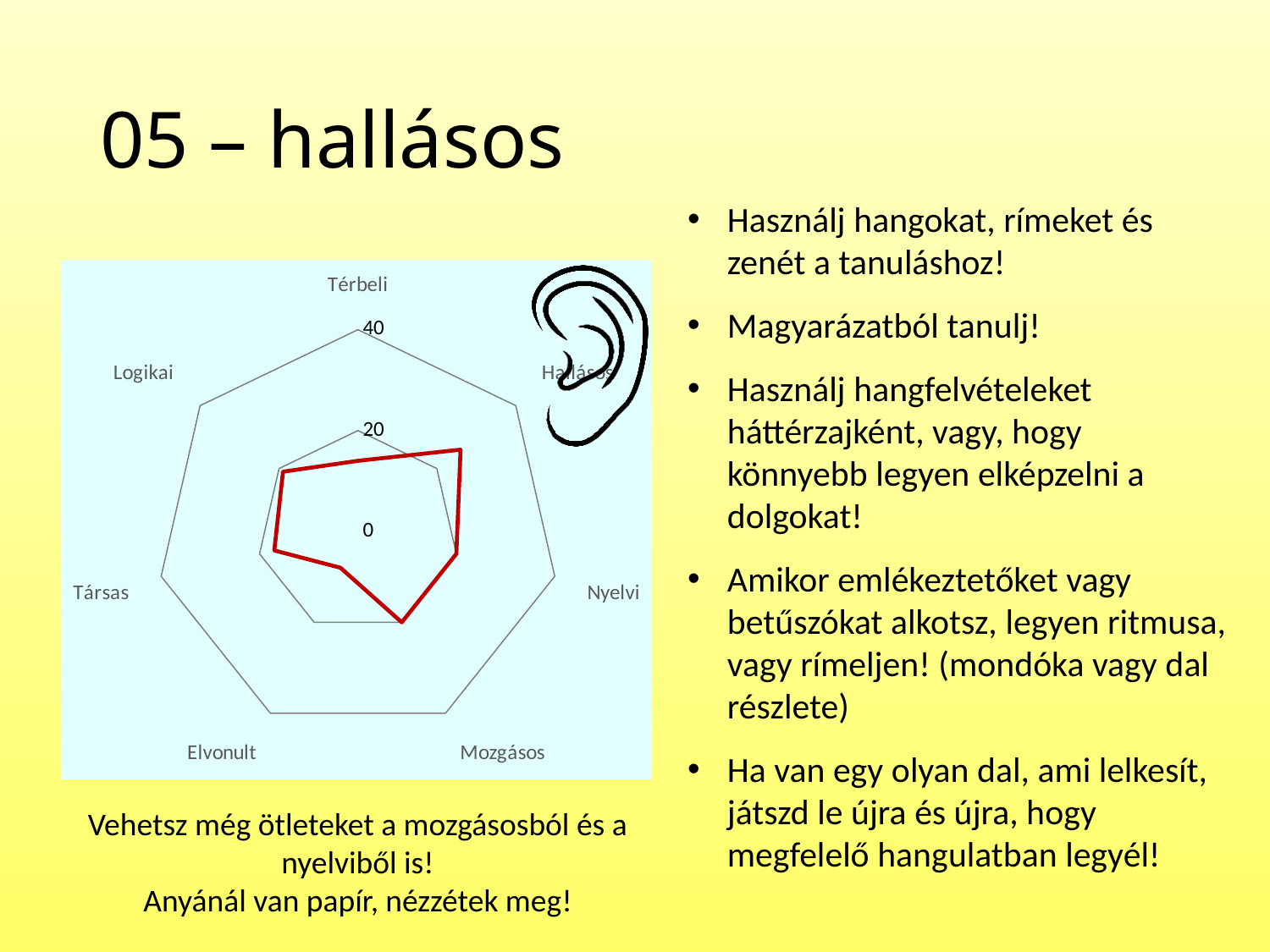
Which is larger, the value for Hallásos or the value for Elvonult? Hallásos What kind of chart is shown on the slide? radar chart Is the value for Hallásos greater or less than 20? greater What is the highest tick value shown on the radar chart's axis? 40 How many categories (axes) does the radar chart have? 7 Is the value for Elvonult greater or less than 20? less Is the value for Hallásos greater or less than 40? less Which category has the highest value in the radar chart? Hallásos Which category has the lowest value in the radar chart? Elvonult Which category label appears at the top of the radar chart? Térbeli